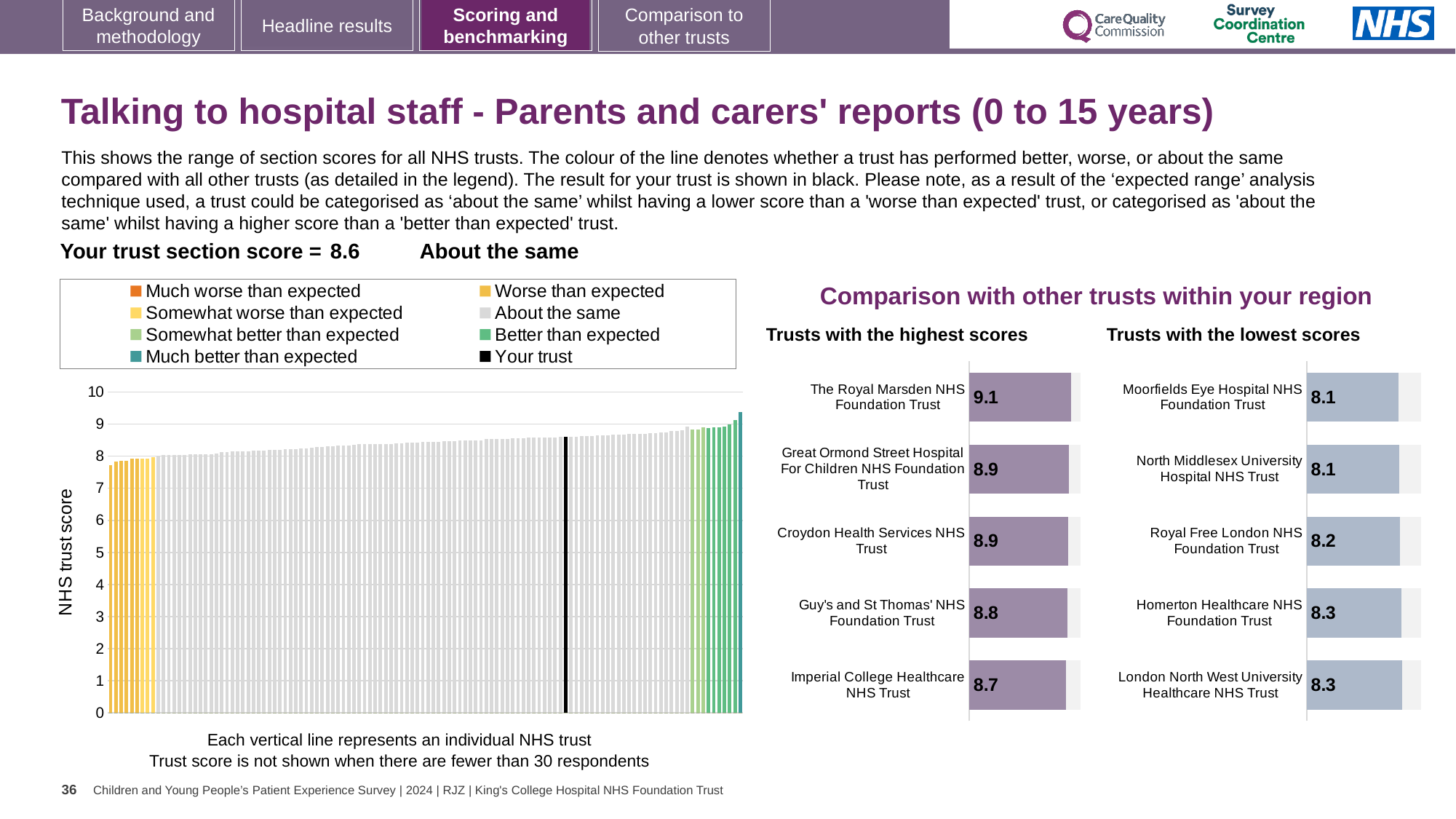
In the 'Trusts with the lowest scores' chart, which is larger: Royal Free London NHS Foundation Trust or Homerton Healthcare NHS Foundation Trust? Homerton Healthcare NHS Foundation Trust What kind of chart is the large chart on the left with the y axis labelled 'NHS trust score'? bar chart In the 'Trusts with the highest scores' chart, which trust has the highest score? The Royal Marsden NHS Foundation Trust In the 'Trusts with the lowest scores' chart, what is the value for Royal Free London NHS Foundation Trust? 8.2 In the 'Trusts with the highest scores' chart, what is the difference between The Royal Marsden NHS Foundation Trust and Imperial College Healthcare NHS Trust? 0.4 In the 'Trusts with the lowest scores' chart, what is the difference between Homerton Healthcare NHS Foundation Trust and Moorfields Eye Hospital NHS Foundation Trust? 0.2 What is the y axis label of the large chart on the left? NHS trust score How many entries does the legend above the large chart on the left list? 8 In the 'Trusts with the highest scores' chart, how many trusts are shown? 5 In the 'Trusts with the highest scores' chart, what is the value for The Royal Marsden NHS Foundation Trust? 9.1 In the 'Trusts with the lowest scores' chart, how many trusts are shown? 5 In the large chart on the left, is the value for the black 'Your trust' bar greater or less than 8? greater